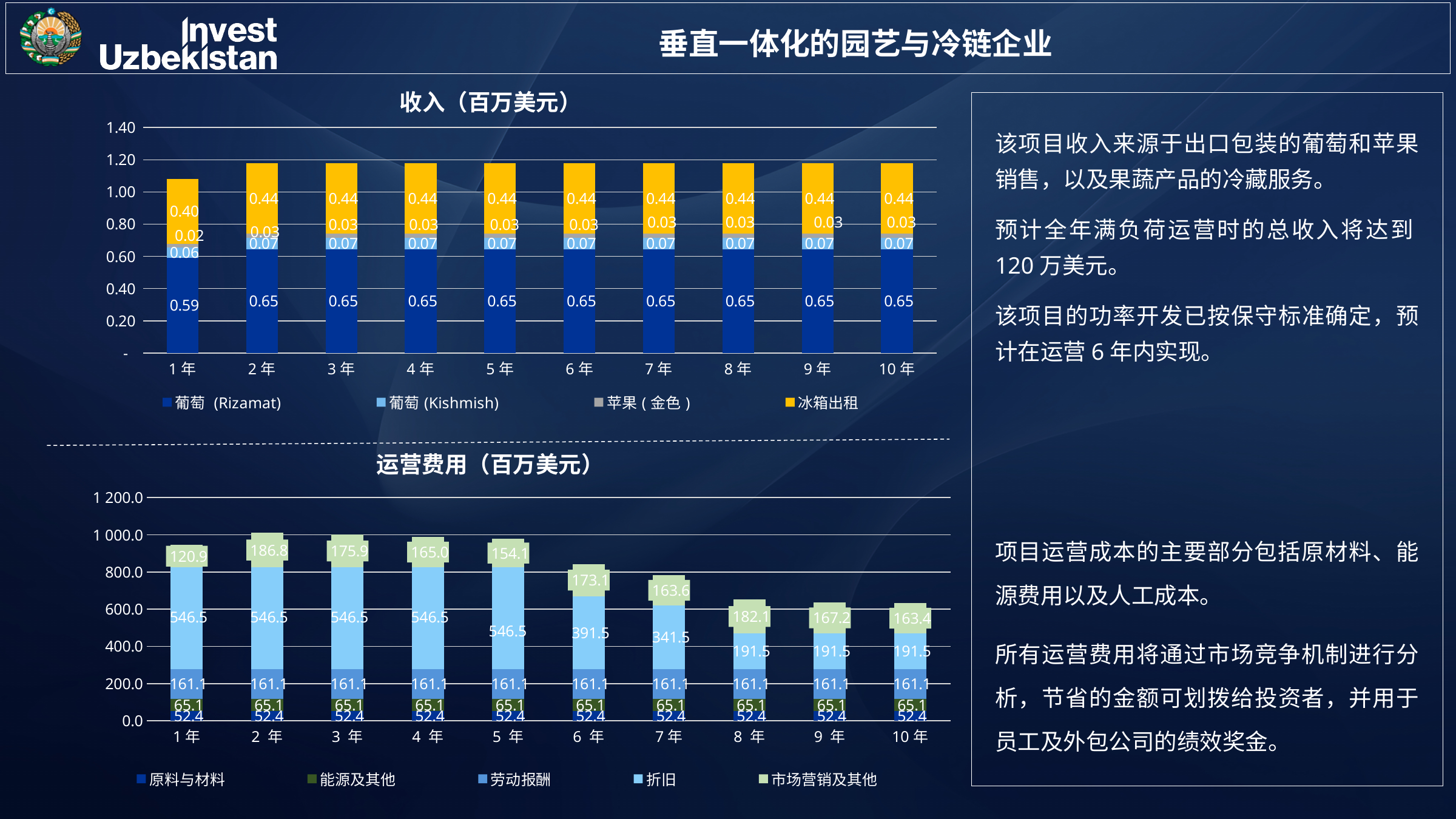
In the 运营费用（百万美元） chart, what is the total of the stacked bar for 8 年? 652.2 In the 收入（百万美元） chart, what is the total of the stacked bar for 1 年? 1.07 In the 运营费用（百万美元） chart, which year has the highest 市场营销及其他 value? 2 年 In the 运营费用（百万美元） chart, what is the value for 市场营销及其他 in 2 年? 186.8 In the 收入（百万美元） chart, what is the value for 苹果 ( 金色 ) in 1 年? 0.02 In the 收入（百万美元） chart, what is the value for 冰箱出租 in 5 年? 0.44 In the 收入（百万美元） chart, what is the difference between the 冰箱出租 value in 2 年 and in 1 年? 0.04 In the 运营费用（百万美元） chart, what is the value for 折旧 in 6 年? 391.5 What kind of chart is the 运营费用（百万美元） chart? Stacked bar chart In the 收入（百万美元） chart, how many series does the legend list? 4 In the 运营费用（百万美元） chart, is the 折旧 value larger in 7 年 or in 8 年? 7 年 In the 收入（百万美元） chart, what is the value for 葡萄 (Rizamat) in 1 年? 0.59